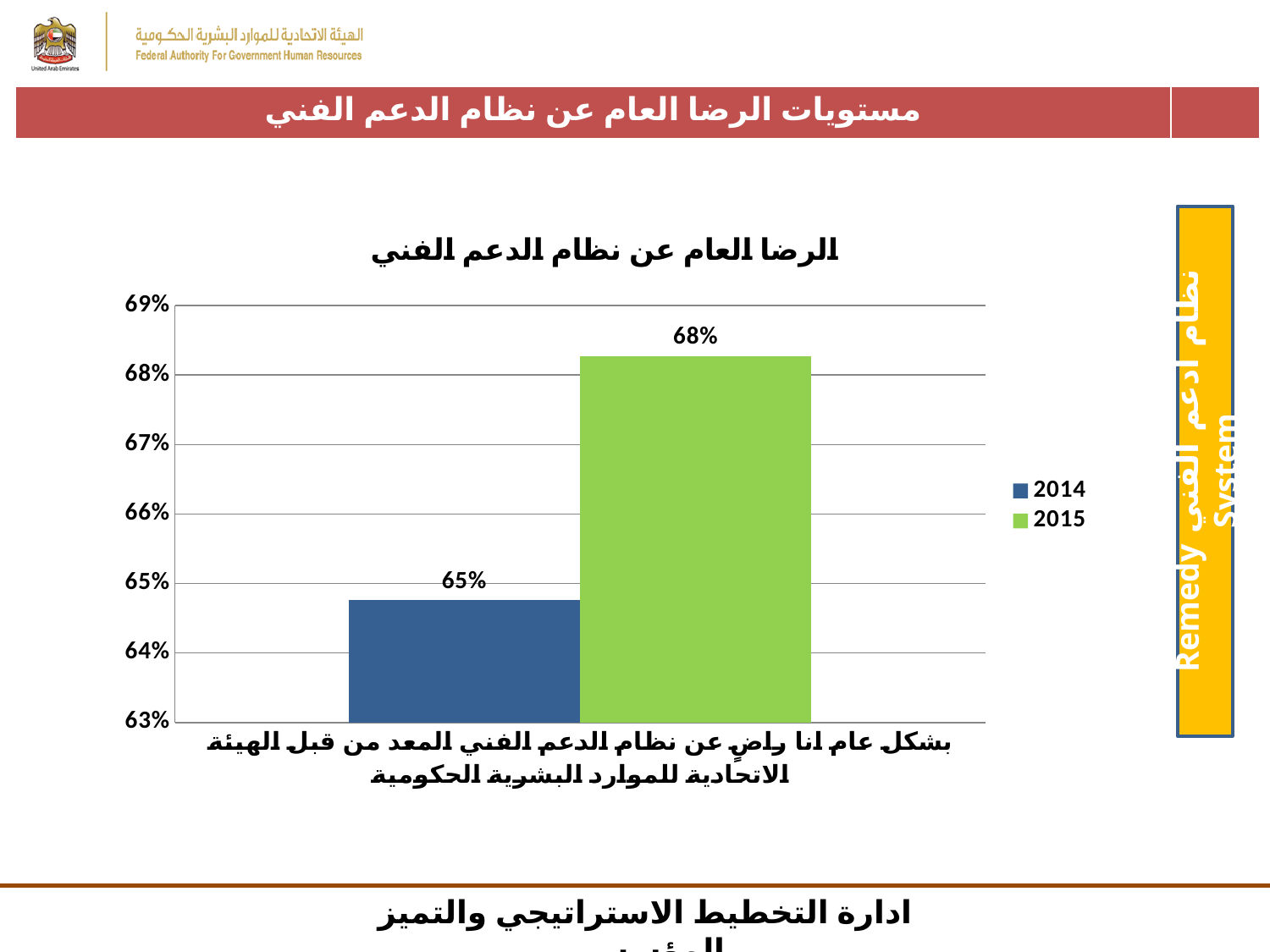
What is the value for 2014? 65% What colour is the bar for 2015? Green What is the difference between the 2015 value and the 2014 value? 3% Does the value rise or fall from 2014 to 2015? Rise Which series has the highest value? 2015 What is the value for 2015? 68% Which series has the lowest value? 2014 Is the value for 2014 greater or less than 66%? less Which year has the higher value, 2014 or 2015? 2015 How many series does the legend list? 2 What kind of chart is shown on the slide? Bar chart Is the value for 2015 greater or less than 67%? greater